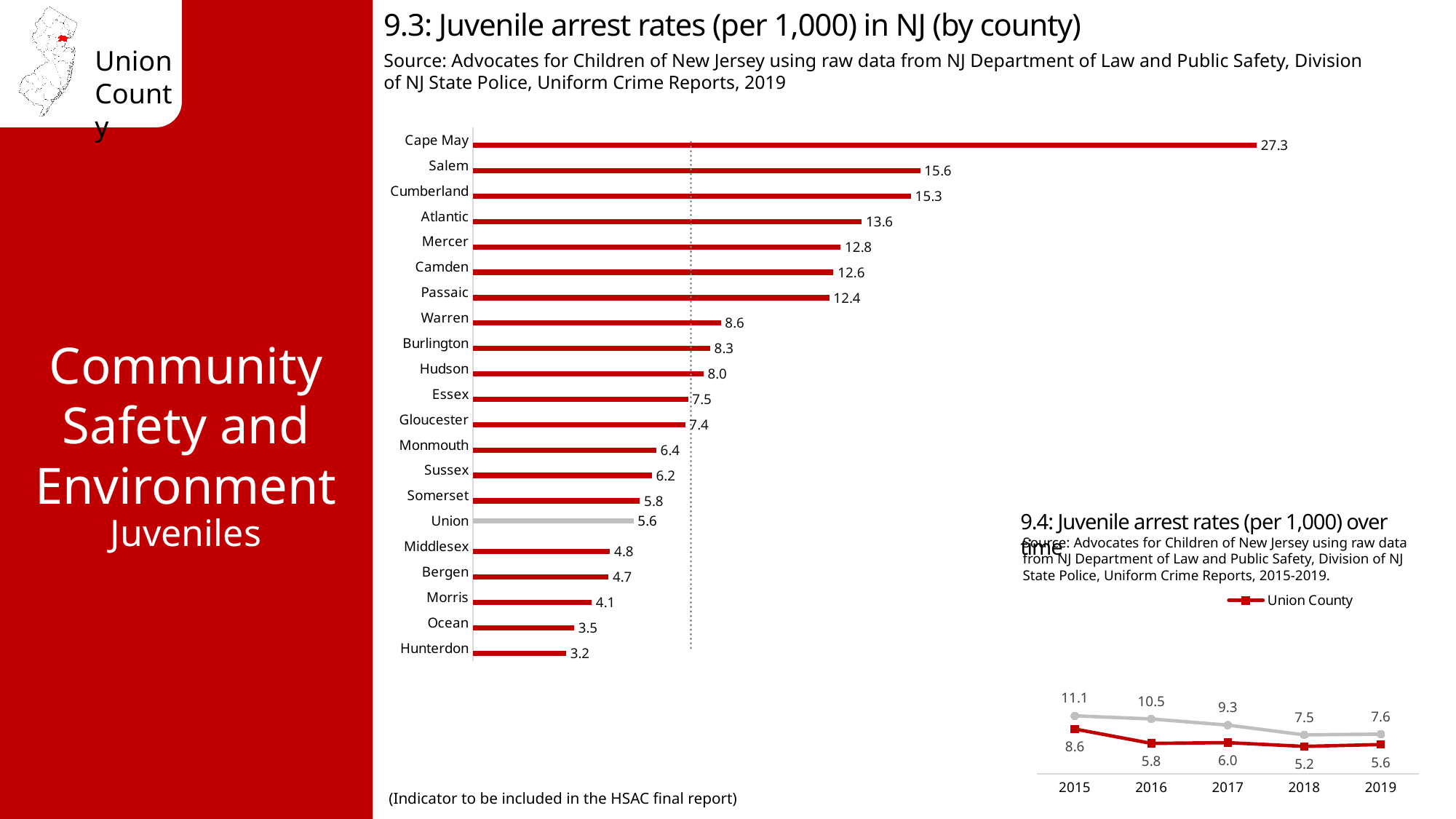
How many counties are shown in the chart '9.3: Juvenile arrest rates (per 1,000) in NJ (by county)'? 21 In the chart '9.3: Juvenile arrest rates (per 1,000) in NJ (by county)', which has a higher value, Mercer or Camden? Mercer In the chart '9.4: Juvenile arrest rates (per 1,000) over time', what is the Union County value for 2018? 5.2 In the chart '9.3: Juvenile arrest rates (per 1,000) in NJ (by county)', which county has the lowest juvenile arrest rate? Hunterdon In the chart '9.3: Juvenile arrest rates (per 1,000) in NJ (by county)', what is the value for Union? 5.6 What kind of chart is '9.3: Juvenile arrest rates (per 1,000) in NJ (by county)'? Bar chart In the chart '9.4: Juvenile arrest rates (per 1,000) over time', what is the Union County value for 2015? 8.6 In the chart '9.3: Juvenile arrest rates (per 1,000) in NJ (by county)', what is the difference between the values for Cape May and Salem? 11.7 In the chart '9.4: Juvenile arrest rates (per 1,000) over time', what is the difference between the Union County values for 2015 and 2019? 3.0 In the chart '9.3: Juvenile arrest rates (per 1,000) in NJ (by county)', what is the value for Passaic? 12.4 In the chart '9.4: Juvenile arrest rates (per 1,000) over time', does the Union County rate rise or fall from 2015 to 2019? Fall In the chart '9.3: Juvenile arrest rates (per 1,000) in NJ (by county)', which county has the highest juvenile arrest rate? Cape May